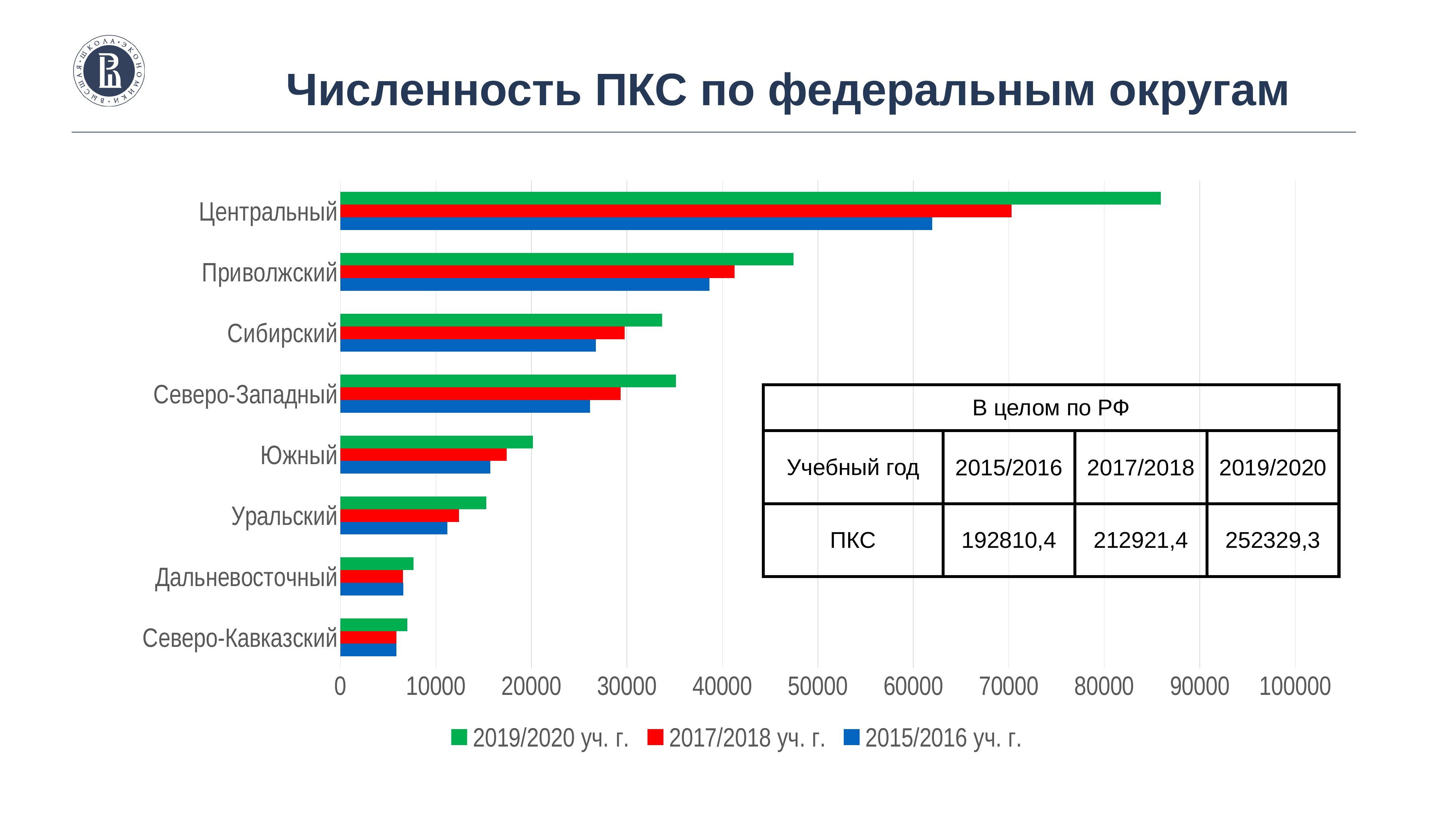
Which is larger for 2017/2018 уч. г.: Южный or Уральский? Южный Is the value for Дальневосточный in 2019/2020 уч. г. greater or less than 10000? less How many series does the chart legend list? 3 What kind of chart is shown on the slide? bar chart How many federal districts (categories) are shown in the chart? 8 Which colour represents the 2015/2016 уч. г. series in the chart? blue Which federal district has the lowest value for 2019/2020 уч. г.? Северо-Кавказский Is the value for Сибирский in 2019/2020 уч. г. greater or less than 30000? greater Which federal district has the highest value for 2019/2020 уч. г.? Центральный Is the value for Центральный in 2019/2020 уч. г. greater or less than 80000? greater Which is larger for 2019/2020 уч. г.: Приволжский or Сибирский? Приволжский